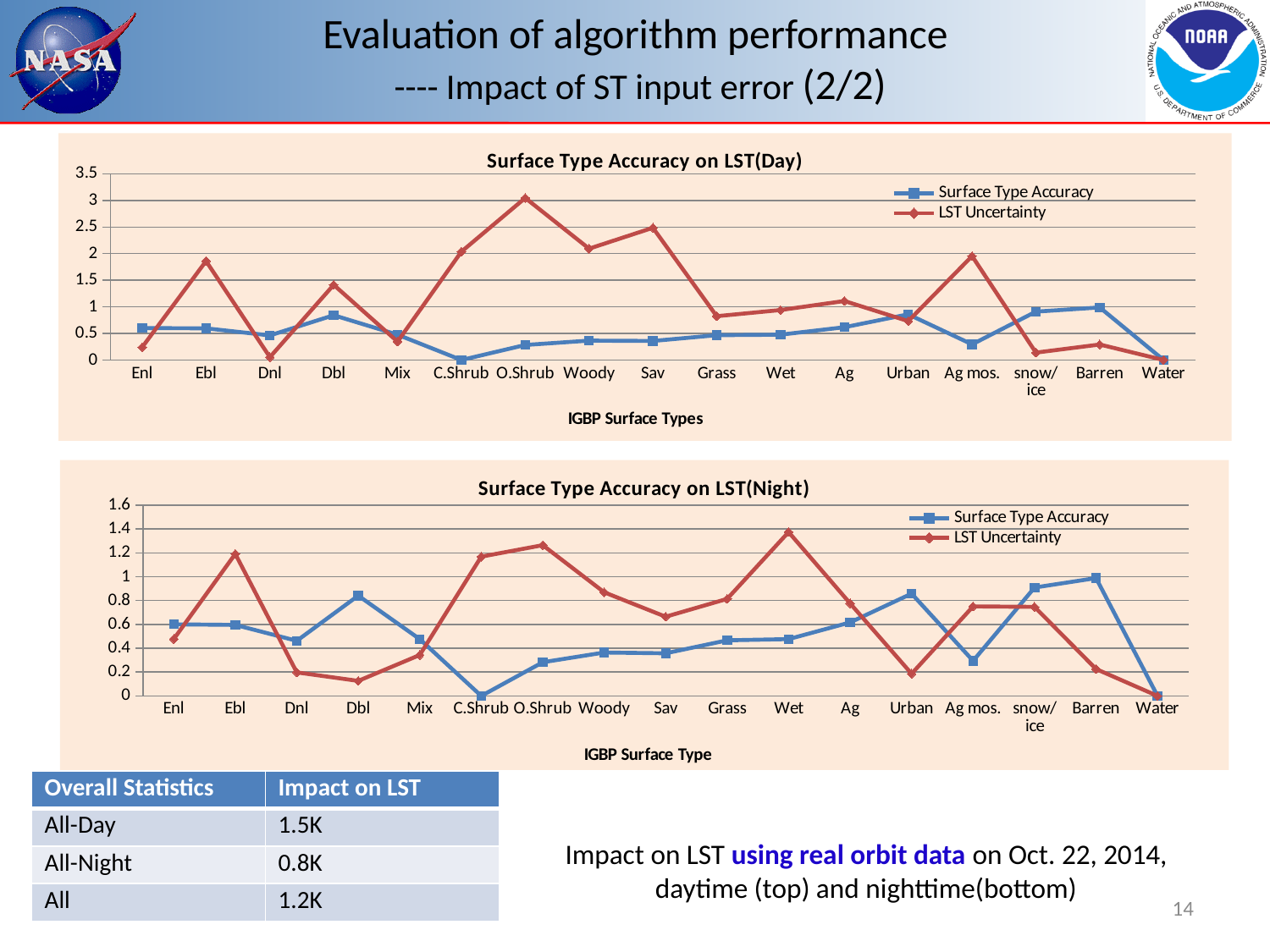
In the 'Surface Type Accuracy on LST(Night)' chart, which surface type has the highest LST Uncertainty? Wet How many series does the legend of the 'Surface Type Accuracy on LST(Night)' chart list? 2 What kind of chart is the 'Surface Type Accuracy on LST(Day)' chart? line chart How many surface type categories are shown on the x axis of the 'Surface Type Accuracy on LST(Day)' chart? 17 In the 'Surface Type Accuracy on LST(Day)' chart, which surface type has the highest LST Uncertainty? O.Shrub In the 'Surface Type Accuracy on LST(Day)' chart, is the LST Uncertainty for Ebl greater or less than 1.5? greater In the 'Surface Type Accuracy on LST(Night)' chart, is the LST Uncertainty for Dbl greater or less than 0.2? less In the 'Surface Type Accuracy on LST(Night)' chart, which series has the larger value at Urban: Surface Type Accuracy or LST Uncertainty? Surface Type Accuracy In the 'Surface Type Accuracy on LST(Night)' chart, is the Surface Type Accuracy for Dbl greater or less than 0.6? greater In the 'Surface Type Accuracy on LST(Day)' chart, which series has the larger value at Ebl: Surface Type Accuracy or LST Uncertainty? LST Uncertainty What is the x-axis title of the 'Surface Type Accuracy on LST(Day)' chart? IGBP Surface Types